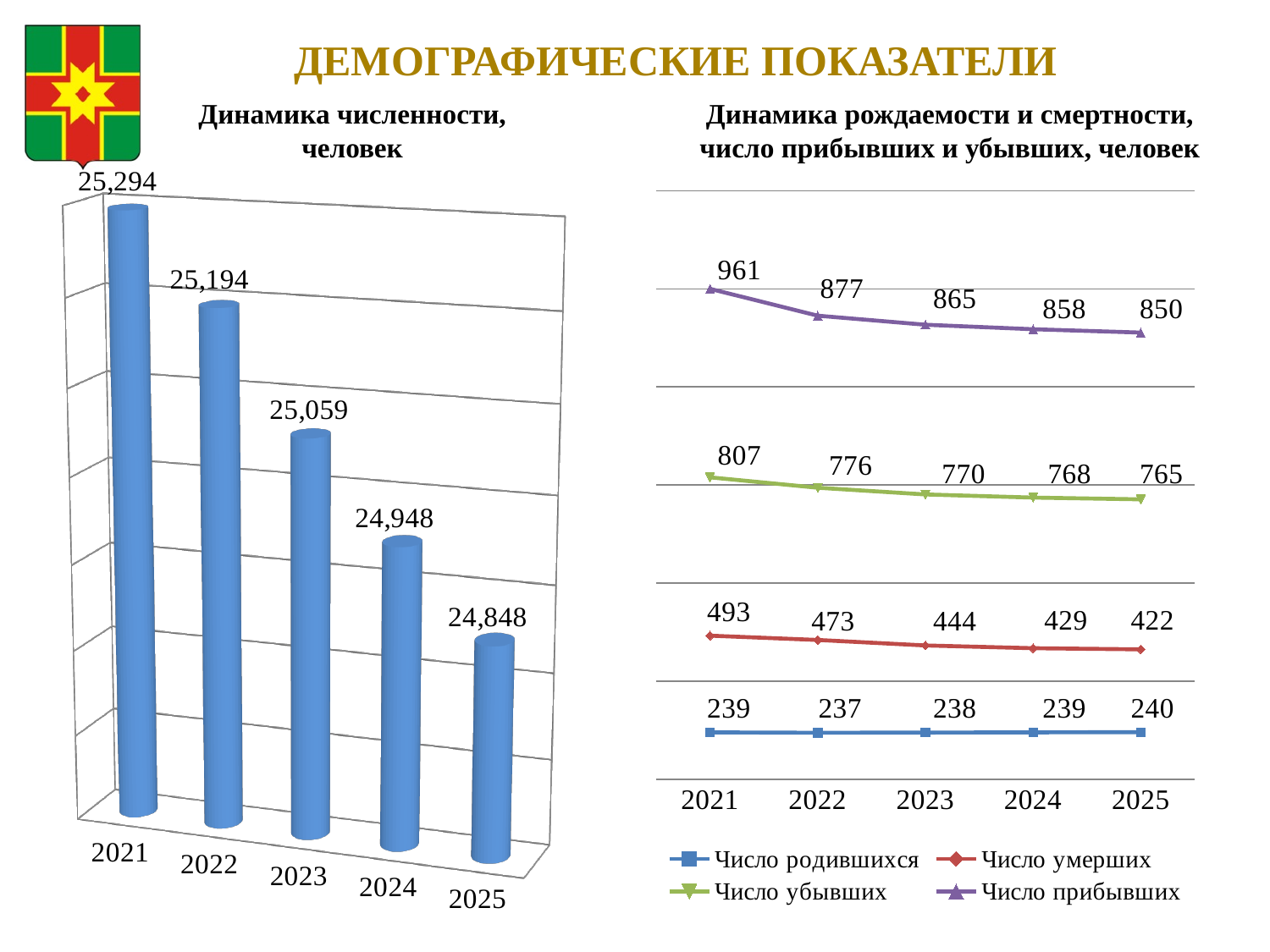
In the chart 'Динамика рождаемости и смертности, число прибывших и убывших, человек', what is the difference between 'Число прибывших' and 'Число убывших' in 2022? 101 What kind of chart is 'Динамика численности, человек'? bar chart How many years are shown on the x axis of the chart 'Динамика рождаемости и смертности, число прибывших и убывших, человек'? 5 In the chart 'Динамика численности, человек', do the values rise or fall from 2021 to 2025? fall In the chart 'Динамика рождаемости и смертности, число прибывших и убывших, человек', what is the value of 'Число прибывших' in 2021? 961 In the chart 'Динамика рождаемости и смертности, число прибывших и убывших, человек', what is the value of 'Число умерших' in 2023? 444 In the chart 'Динамика рождаемости и смертности, число прибывших и убывших, человек', which is larger in 2025: 'Число убывших' or 'Число умерших'? Число убывших In the chart 'Динамика численности, человек', what is the difference between the 2021 and 2025 values? 446 In the chart 'Динамика рождаемости и смертности, число прибывших и убывших, человек', how many series does the legend list? 4 In the chart 'Динамика численности, человек', which year has the lowest value? 2025 In the chart 'Динамика рождаемости и смертности, число прибывших и убывших, человек', in which year is 'Число родившихся' highest? 2025 In the chart 'Динамика численности, человек', what is the value for 2023? 25,059